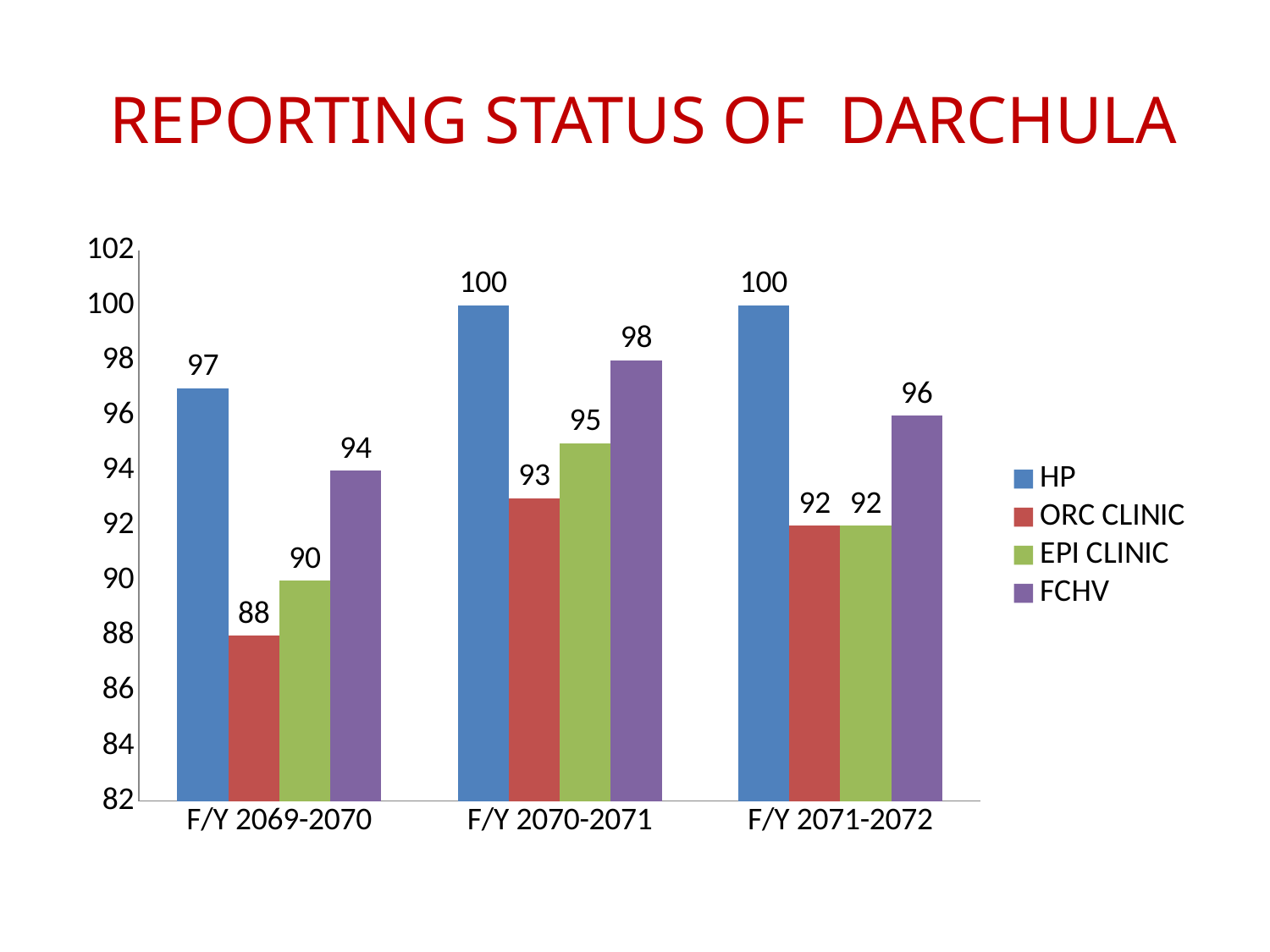
Which series has the highest value in F/Y 2070-2071? HP What kind of chart is shown on the slide? bar chart What is the difference between the HP and ORC CLINIC values in F/Y 2069-2070? 9 What is the title of the slide? REPORTING STATUS OF DARCHULA What is the value for HP in F/Y 2069-2070? 97 How many series does the legend list? 4 What is the value for ORC CLINIC in F/Y 2070-2071? 93 What is the value for FCHV in F/Y 2071-2072? 96 Which is larger, the EPI CLINIC value in F/Y 2070-2071 or the EPI CLINIC value in F/Y 2071-2072? F/Y 2070-2071 Which series has the lowest value in F/Y 2069-2070? ORC CLINIC How many fiscal year categories are shown on the x axis? 3 Does the ORC CLINIC value rise or fall from F/Y 2069-2070 to F/Y 2071-2072? rise